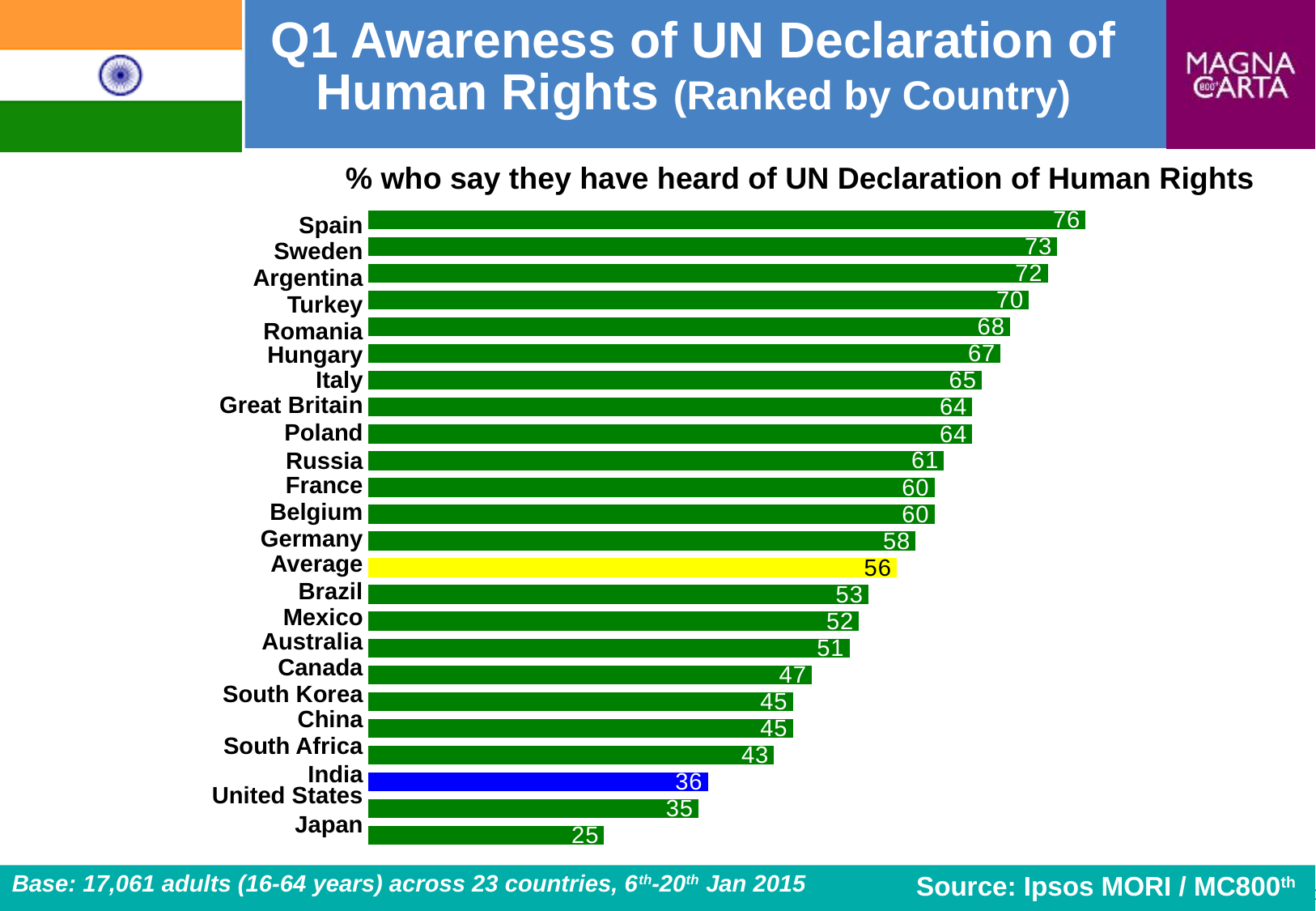
What type of chart is used on this slide? Bar chart What is the value shown for India? 36 Which has a higher value, Canada or South Africa? Canada How many bars are shown in the chart, including the Average bar? 24 What is the difference between the values for Germany and the Average? 2 Which bar is coloured blue in the chart? India Which country has the highest percentage who say they have heard of the UN Declaration of Human Rights? Spain What is the difference between the values for Spain and Japan? 51 Which country has the lowest percentage who say they have heard of the UN Declaration of Human Rights? Japan What percentage of people in Spain say they have heard of the UN Declaration of Human Rights? 76 What is the value shown for the Average bar? 56 Which has a higher value, India or the United States? India